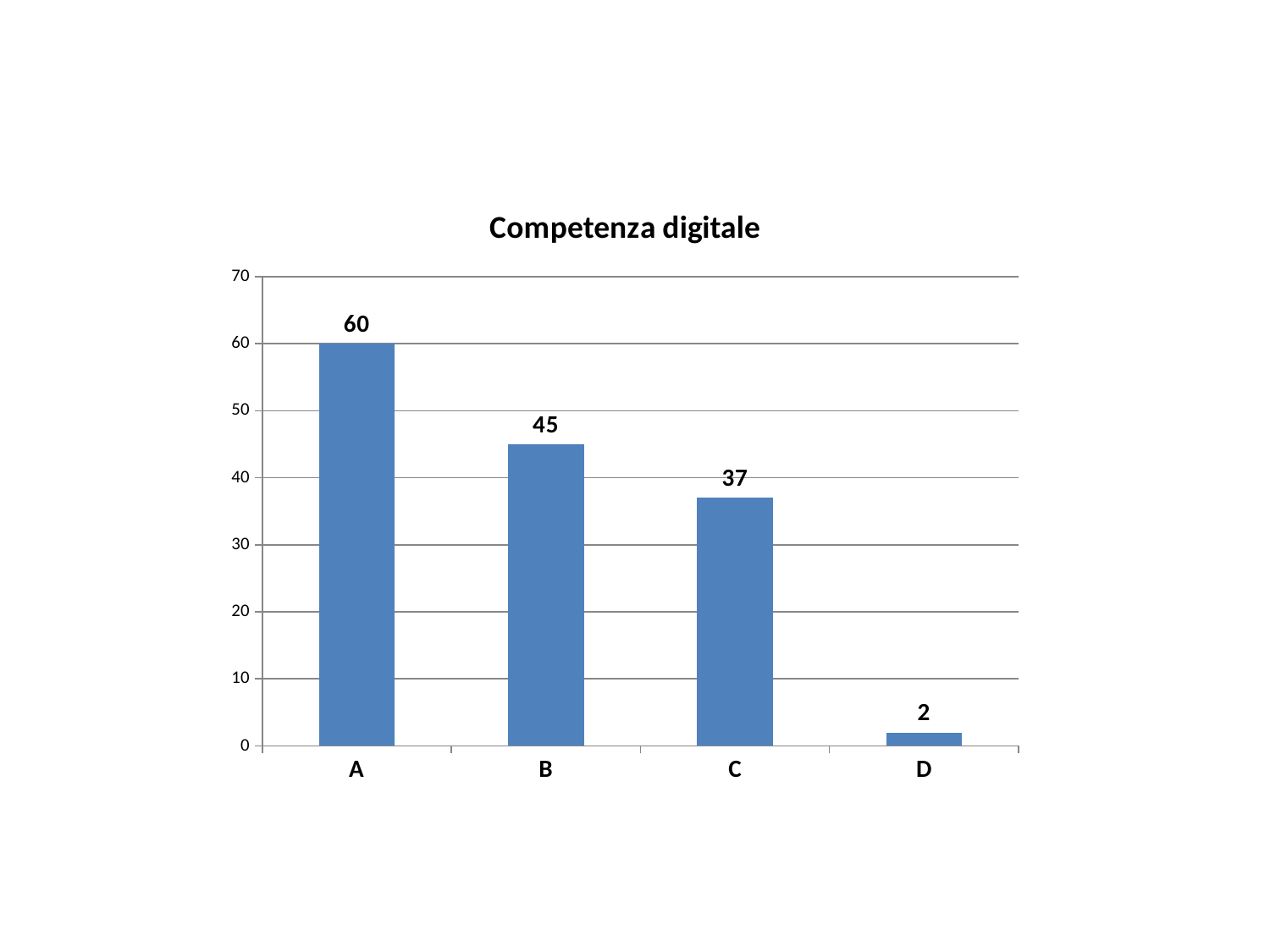
What is the title of the chart? Competenza digitale Which category has the highest value? A What is the value for category C? 37 What is the difference between the values for A and B? 15 Is the value for C greater or less than 40? less What kind of chart is shown on the slide? bar chart How many categories are shown on the x axis? 4 What is the difference between the values for B and C? 8 What is the value for category A? 60 What is the value for category D? 2 Which category has the lowest value? D Which is larger, the value for B or the value for C? B